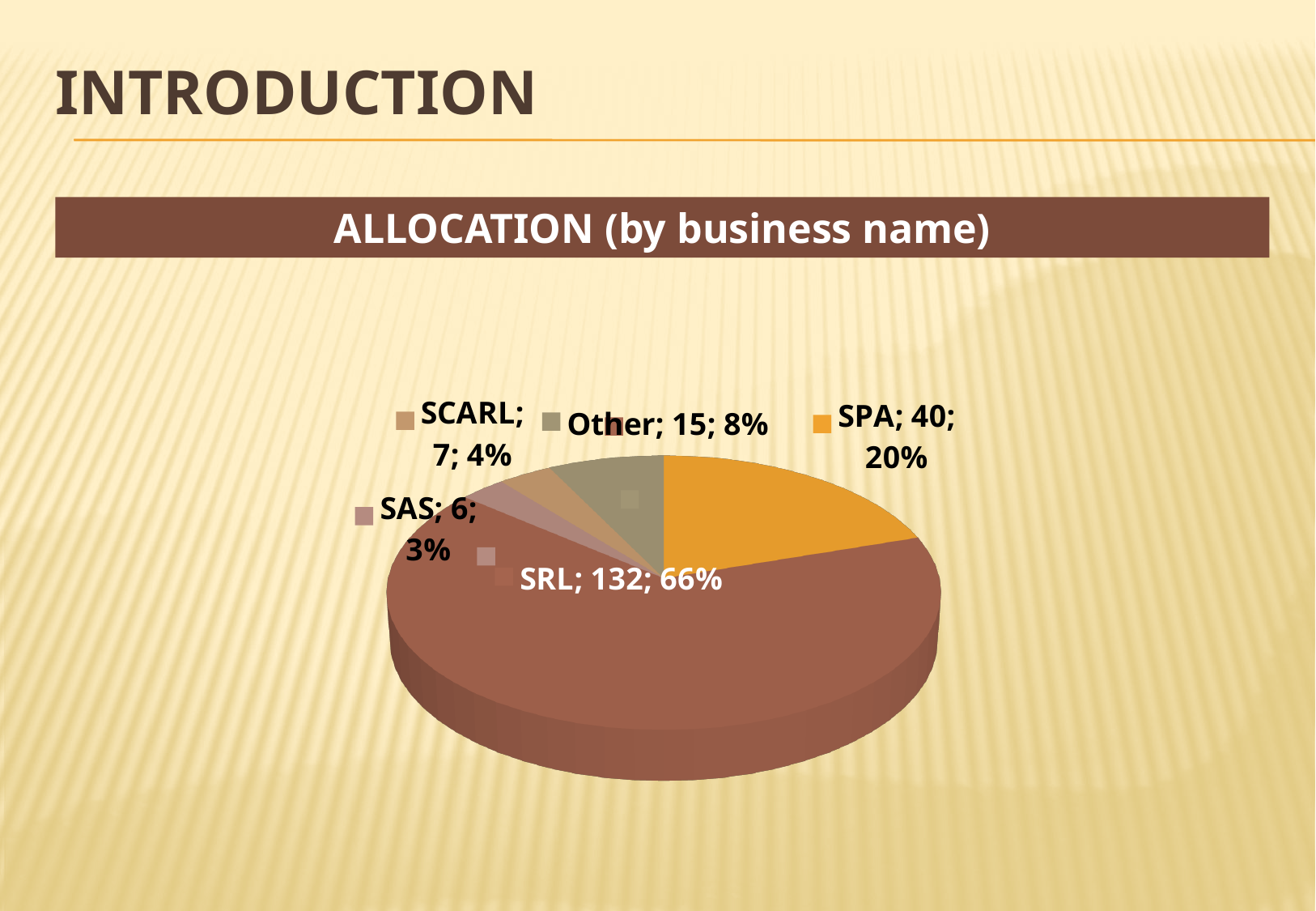
What is the value for Other? 15 What is the value for SAS? 6 Which category has the largest slice? SRL Which category has the smallest slice? SAS What kind of chart is shown on the slide? pie chart Which is larger, the value for Other or the value for SCARL? Other What is the value for SRL? 132 How many slices does the pie chart have? 5 What share of the pie does SPA represent? 20% What is the difference between the values for SRL and SPA? 92 What share of the pie does SCARL represent? 4% What is the value for SPA? 40